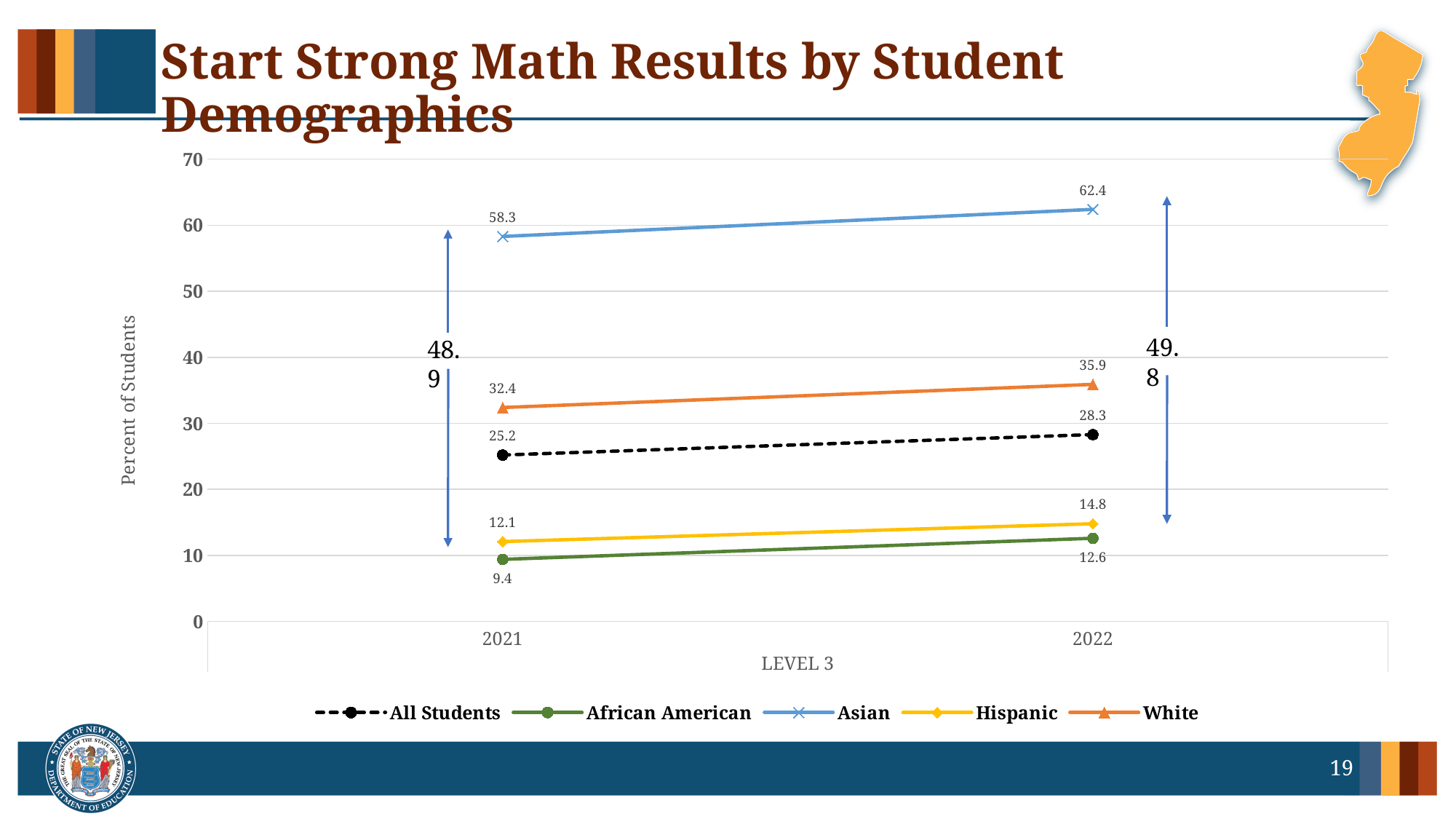
What is the label on the vertical axis? Percent of Students Which group has the lowest value in 2022? African American Which group has the highest value in 2021? Asian How many series does the legend list? 5 What is the difference between the White values in 2022 and 2021? 3.5 What is the value for Hispanic students in 2022? 14.8 Do the values for African American students rise or fall from 2021 to 2022? Rise What is the difference between the Asian and African American values in 2021? 48.9 Which is larger in 2022, the value for White students or the value for All Students? White What is the value for All Students in 2021? 25.2 What kind of chart is this? Line chart What is the value for Asian students in 2022? 62.4